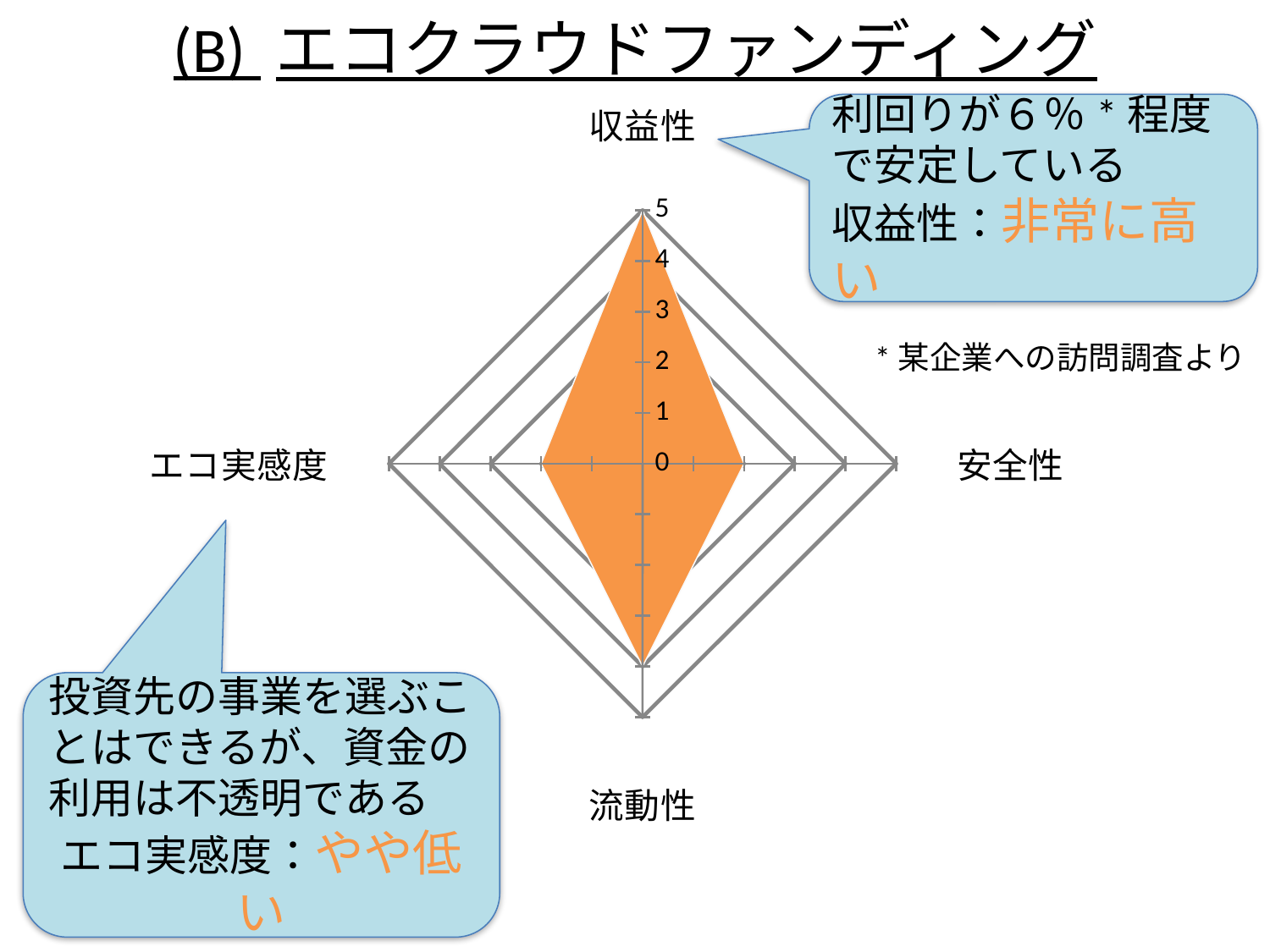
What is the value for 収益性 on the radar chart? 5 Which category has the highest value on the radar chart? 収益性 Is the value for エコ実感度 greater or less than 3? less Which is larger, the value for 流動性 or the value for エコ実感度? 流動性 Is the value for 安全性 greater or less than 3? less What is the title of the slide containing the radar chart? (B) エコクラウドファンディング How many axes (categories) does the radar chart have? 4 Which category is plotted at the bottom of the radar chart? 流動性 Which is larger, the value for 収益性 or the value for 安全性? 収益性 Is the value for 流動性 greater or less than 3? greater What is the maximum value shown on the radar chart's axis scale? 5 What kind of chart is shown on the slide? Radar chart